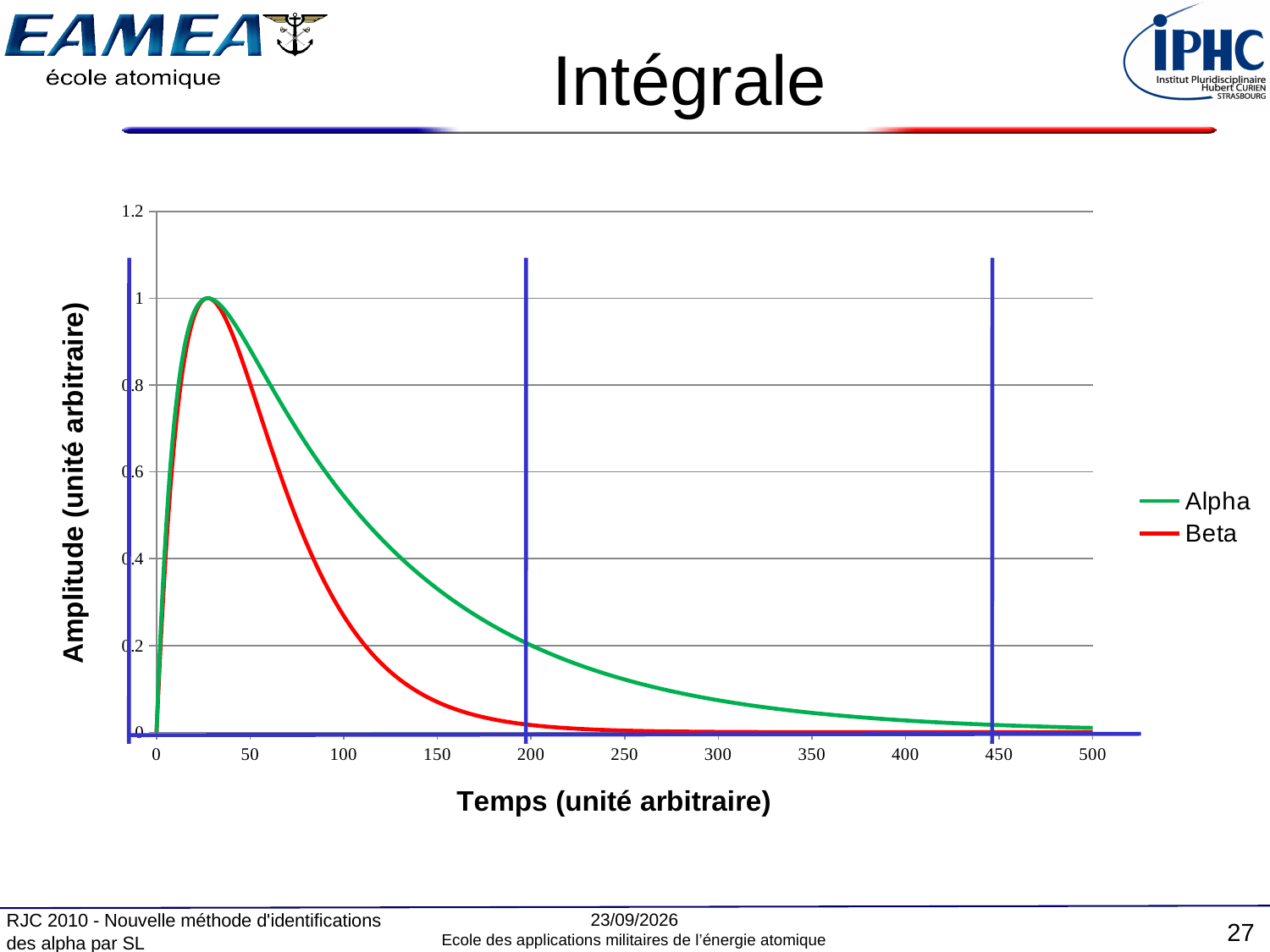
After the peak near time 30, do the amplitude values rise or fall as time increases? fall At time 300, is the Alpha value greater or less than 0.2? less What is the title of the chart's x axis? Temps (unité arbitraire) What kind of chart is shown on the slide? line chart At time 150, is the Beta value greater or less than 0.2? less At time 50, is the Alpha value greater or less than 0.6? greater How many series does the legend list? 2 Which series decays to zero faster after its peak, Alpha or Beta? Beta What is the peak amplitude reached by the Alpha curve? 1 What colour is the Alpha line in the chart? green At time 100, which series has the larger amplitude, Alpha or Beta? Alpha